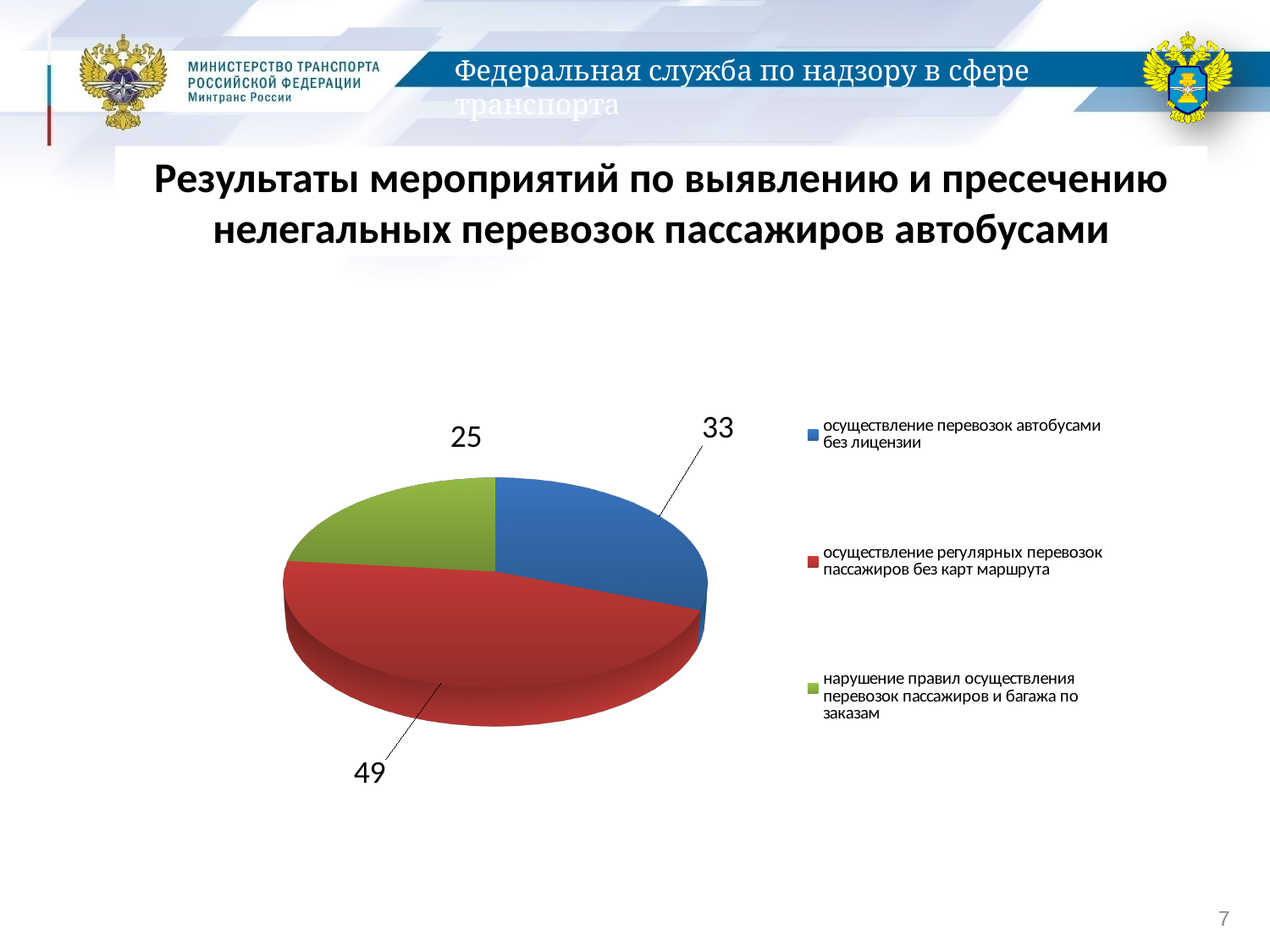
Which category has the smallest slice of the pie? нарушение правил осуществления перевозок пассажиров и багажа по заказам What is the difference between the value for 'осуществление перевозок автобусами без лицензии' and the value for 'нарушение правил осуществления перевозок пассажиров и багажа по заказам'? 8 What colour is the slice for 'осуществление регулярных перевозок пассажиров без карт маршрута'? red What value is shown for the slice 'нарушение правил осуществления перевозок пассажиров и багажа по заказам'? 25 What is the difference between the value for 'осуществление регулярных перевозок пассажиров без карт маршрута' and the value for 'осуществление перевозок автобусами без лицензии'? 16 Which category has the largest slice of the pie? осуществление регулярных перевозок пассажиров без карт маршрута What value is shown for the slice 'осуществление регулярных перевозок пассажиров без карт маршрута'? 49 Which is larger: the value for 'осуществление перевозок автобусами без лицензии' or the value for 'нарушение правил осуществления перевозок пассажиров и багажа по заказам'? осуществление перевозок автобусами без лицензии What value is shown for the slice 'осуществление перевозок автобусами без лицензии'? 33 What kind of chart is shown on the slide? pie chart How many slices does the pie chart have? 3 What is the total of all the values shown on the pie chart? 107